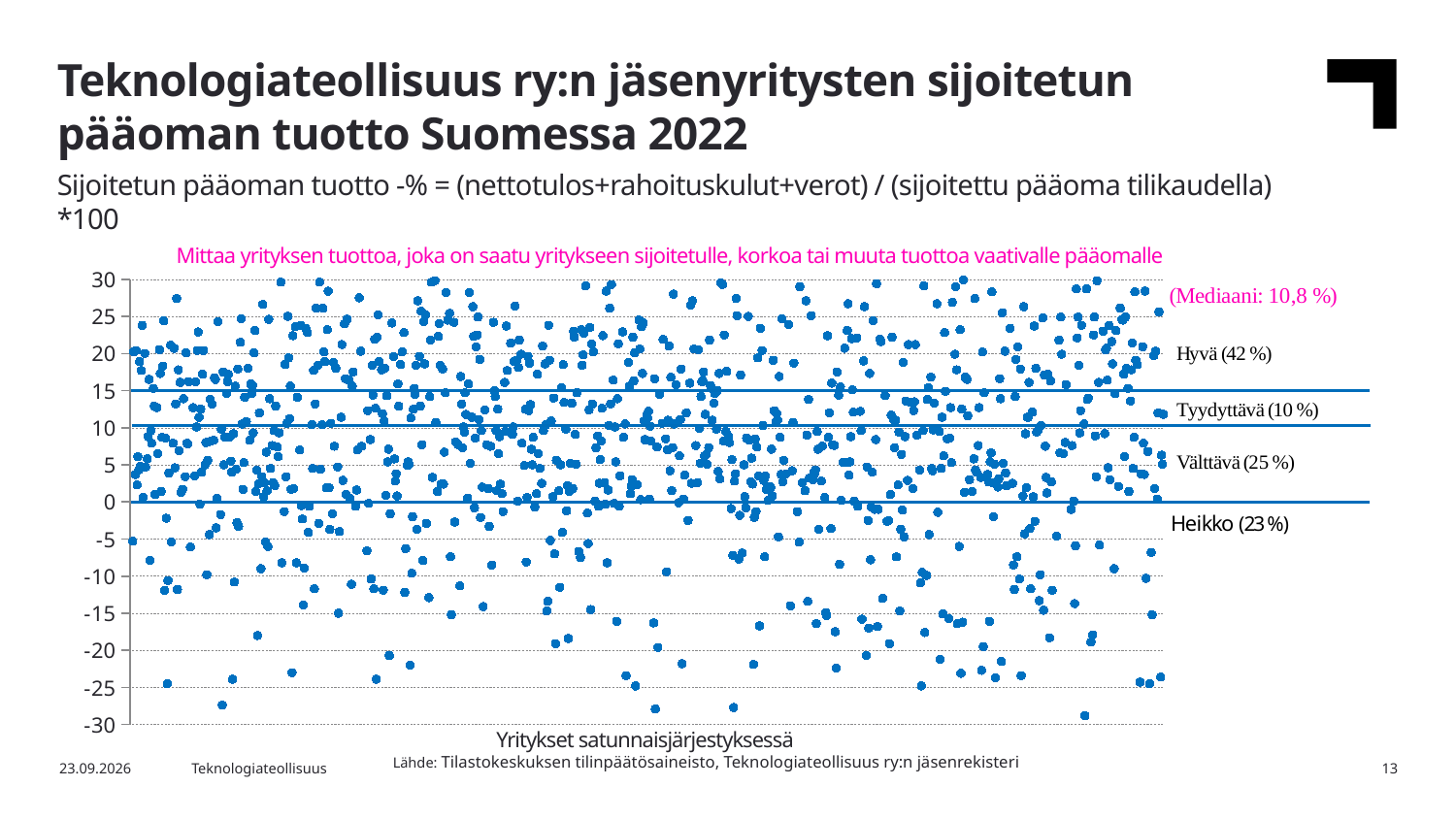
What share of companies falls into the 'Heikko' category? 23 % Which category has the smallest share of companies? Tyydyttävä Which category has a larger share of companies, 'Välttävä' or 'Heikko'? Välttävä How many rating categories are labelled on the chart? 4 How many percentage points larger is the 'Hyvä' share than the 'Heikko' share? 19 What is the median return on invested capital (Mediaani) shown on the chart? 10,8 % What share of companies falls into the 'Tyydyttävä' category? 10 % Which category has the largest share of companies? Hyvä What share of companies falls into the 'Välttävä' category? 25 % What kind of chart is shown on the slide? Scatter chart What share of companies falls into the 'Hyvä' category? 42 % What is the label of the x axis? Yritykset satunnaisjärjestyksessä